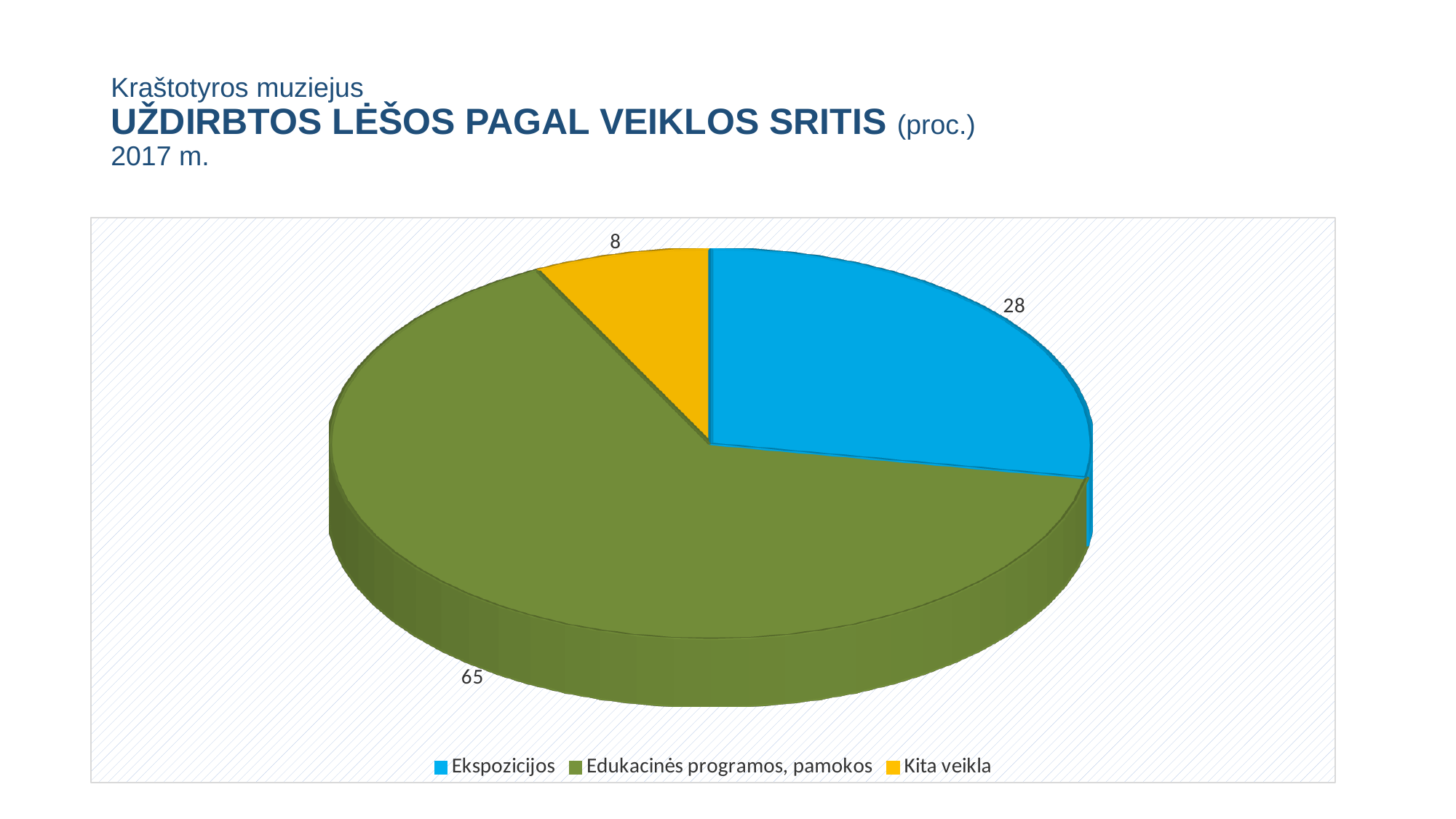
Which category has the smallest slice? Kita veikla How many slices does the pie chart have? 3 Which category has the largest slice? Edukacinės programos, pamokos What is the difference between the values for Edukacinės programos, pamokos and Ekspozicijos? 37 How many entries does the legend list? 3 What is the value for Kita veikla? 8 Which is larger, the value for Ekspozicijos or the value for Kita veikla? Ekspozicijos Which year does the chart title refer to? 2017 m. What is the value for Edukacinės programos, pamokos? 65 What colour is the slice for Kita veikla? yellow What is the value for Ekspozicijos? 28 What kind of chart is shown on the slide? pie chart